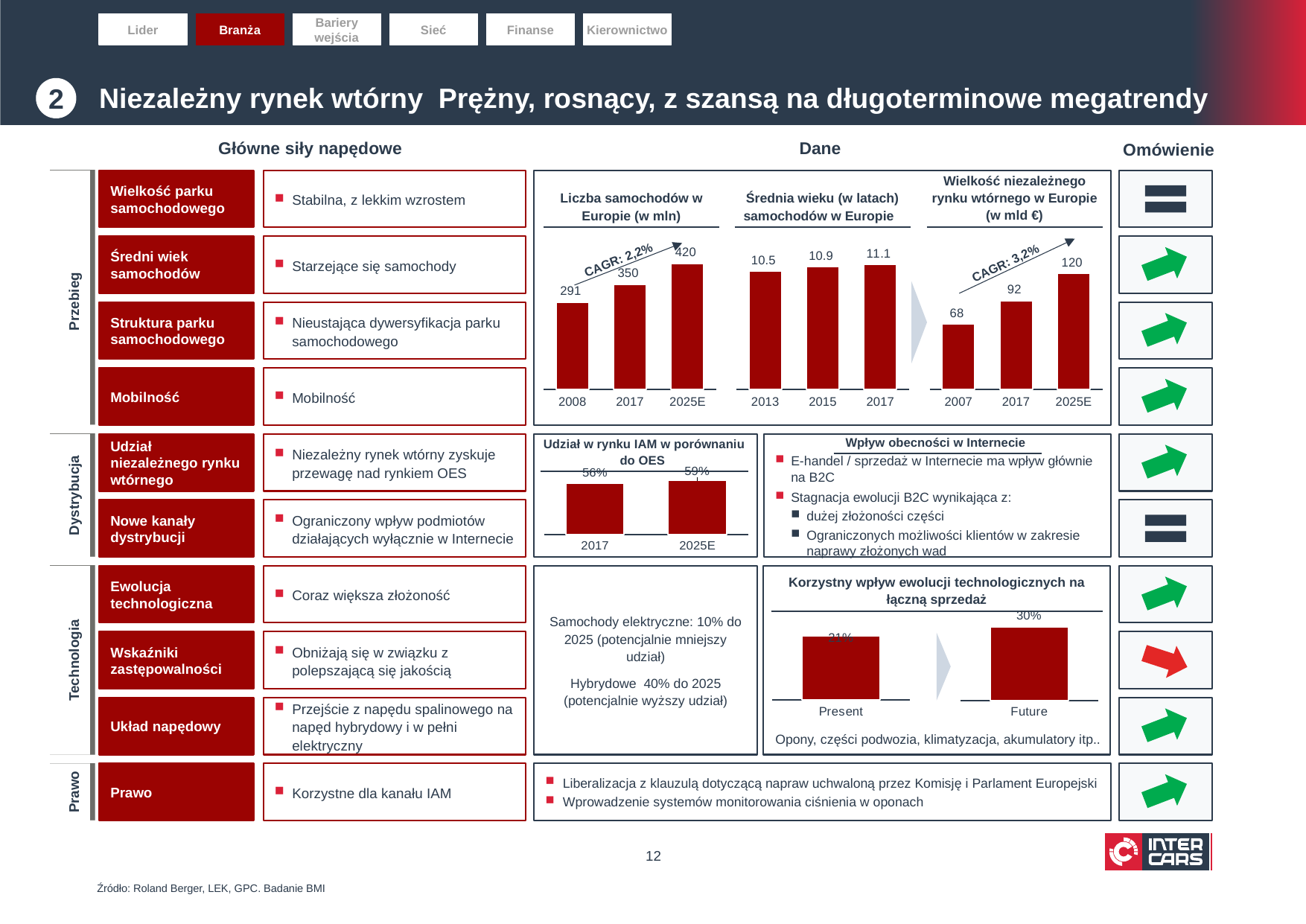
In the chart 'Liczba samochodów w Europie (w mln)', what is the value for 2017? 350 What type of chart is 'Liczba samochodów w Europie (w mln)'? bar chart In the chart 'Wielkość niezależnego rynku wtórnego w Europie (w mld €)', what is the value for 2007? 68 In the chart 'Udział w rynku IAM w porównaniu do OES', what is the value for 2025E? 59% In the chart 'Udział w rynku IAM w porównaniu do OES', how many bars are shown? 2 In the chart 'Średnia wieku (w latach) samochodów w Europie', do the values rise or fall from 2013 to 2017? rise In the chart 'Średnia wieku (w latach) samochodów w Europie', which year has the highest value? 2017 In the chart 'Wielkość niezależnego rynku wtórnego w Europie (w mld €)', what is the difference between the 2025E and 2017 values? 28 In the chart 'Liczba samochodów w Europie (w mln)', what is the value for 2025E? 420 In the chart 'Liczba samochodów w Europie (w mln)', what is the difference between the 2025E and 2008 values? 129 In the chart 'Wielkość niezależnego rynku wtórnego w Europie (w mld €)', what CAGR is shown? CAGR: 3.2% In the chart 'Średnia wieku (w latach) samochodów w Europie', what is the value for 2015? 10.9